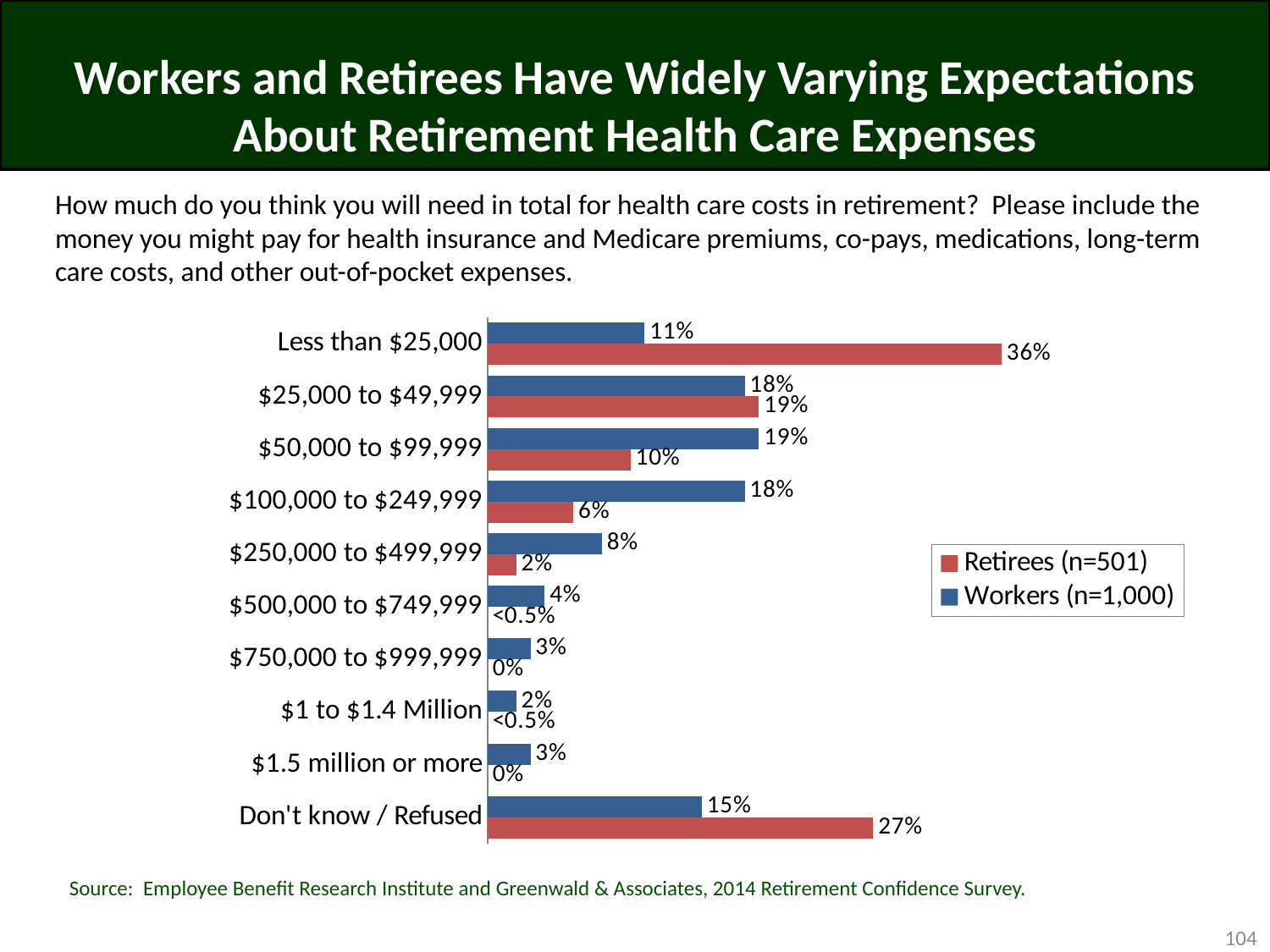
Which is larger for the $250,000 to $499,999 category: Workers (n=1,000) or Retirees (n=501)? Workers (n=1,000) What is the difference between the Retirees (n=501) and Workers (n=1,000) values for Less than $25,000? 25% What is the value for Retirees (n=501) in the Don't know / Refused category? 27% What percentage of Retirees (n=501) expect to need less than $25,000 for health care costs in retirement? 36% What is the value for Workers (n=1,000) in the $100,000 to $249,999 category? 18% How many series does the legend list? 2 What kind of chart is shown on the slide? Bar chart How many categories are shown on the chart? 10 What colour represents Retirees (n=501) in the chart? Red Which category has the lowest value for Workers (n=1,000)? $1 to $1.4 Million Which category has the highest value for Retirees (n=501)? Less than $25,000 What percentage of Workers (n=1,000) expect to need $50,000 to $99,999? 19%